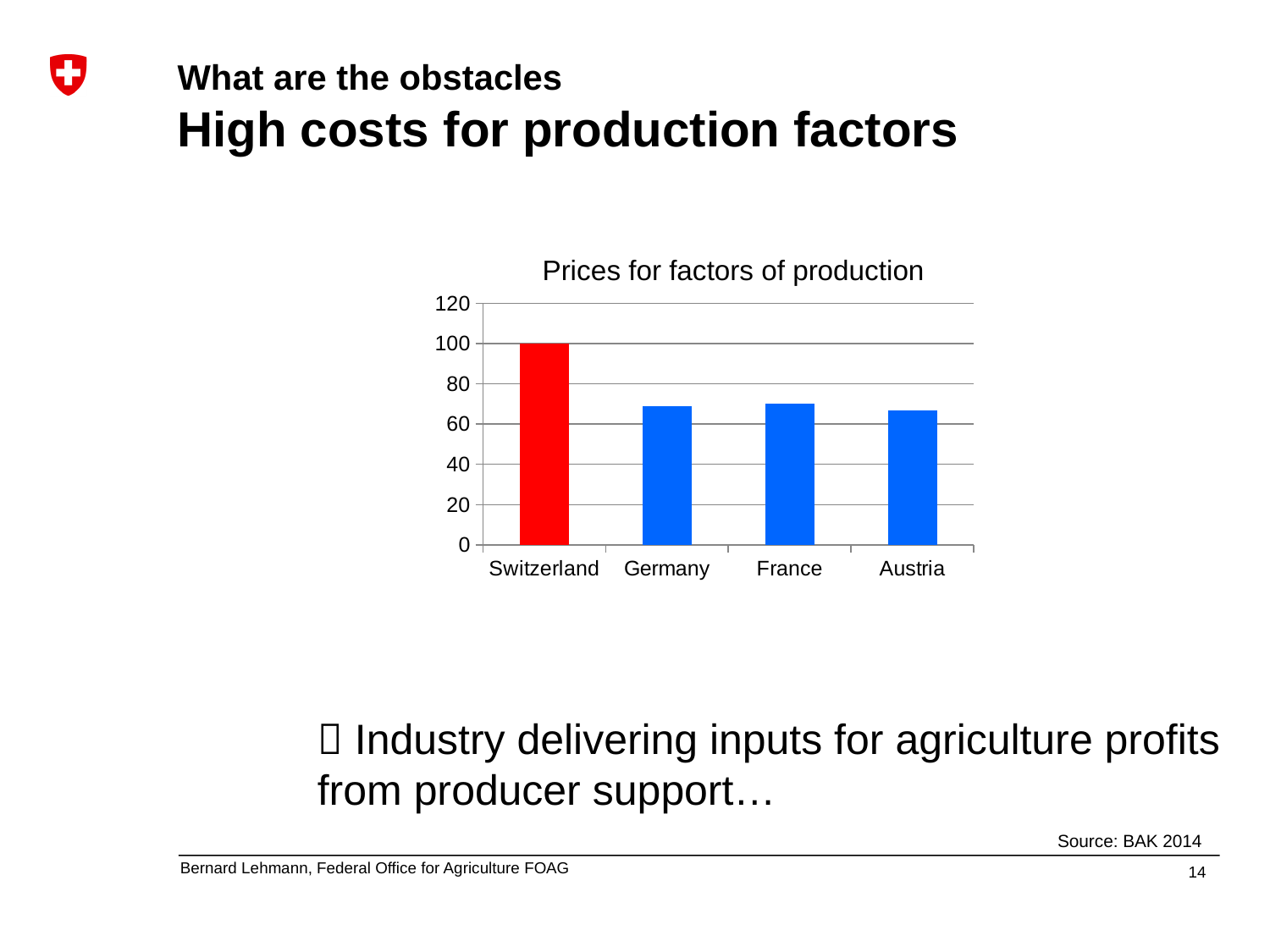
What is the title of the chart? Prices for factors of production What colour is the bar for Switzerland? red What is the value for Switzerland in the chart? 100 Which has the larger value, Switzerland or Germany? Switzerland Which country has the highest value in the chart? Switzerland How many countries are shown on the x axis of the chart? 4 Is the value for Austria greater or less than 80? less Which has the larger value, Austria or Switzerland? Switzerland Is the value for Germany greater or less than 80? less Is the value for France greater or less than 60? greater What kind of chart is shown on the slide? bar chart